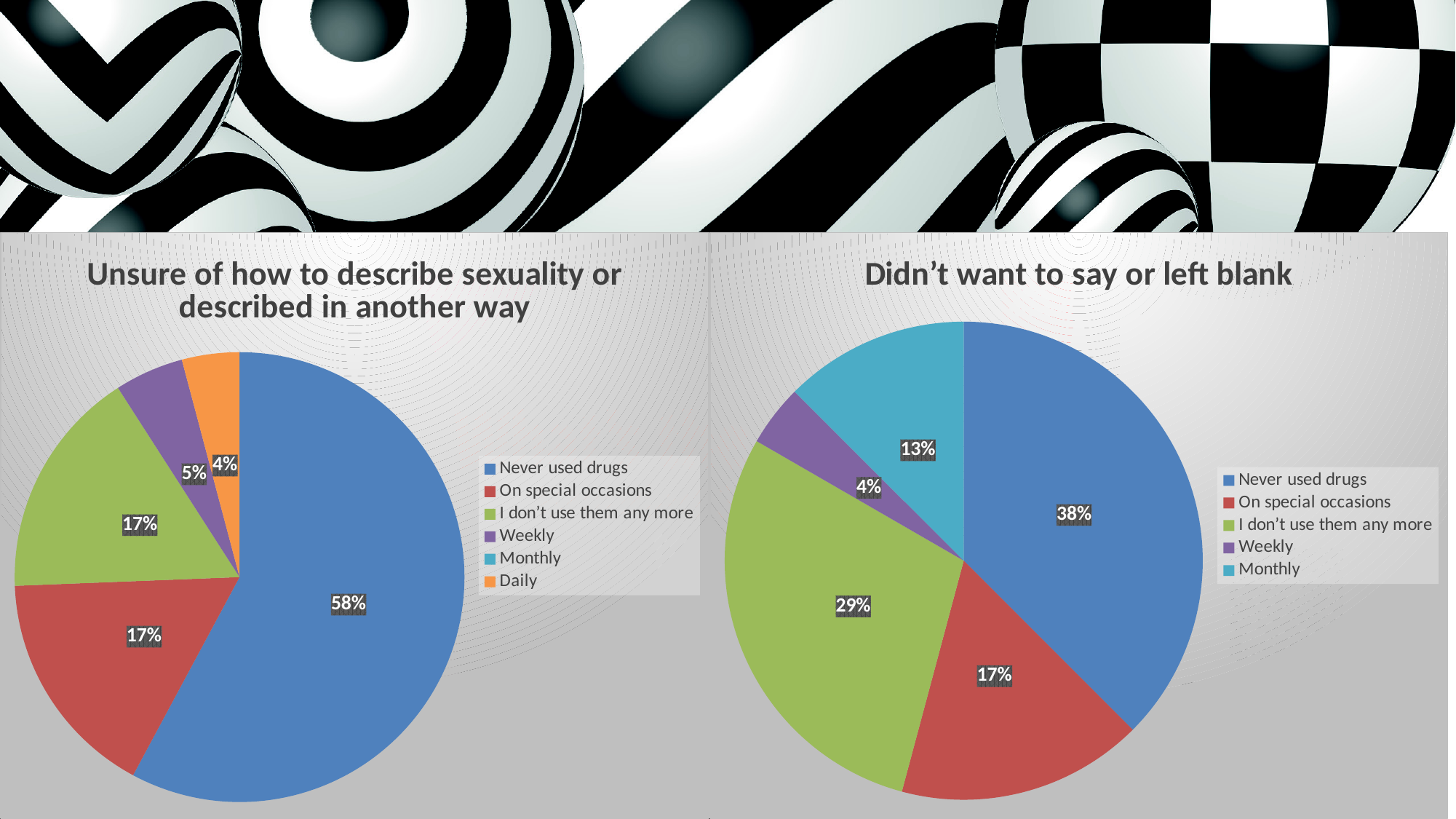
What kind of chart is the 'Unsure of how to describe sexuality or described in another way' chart? Pie chart In the 'Didn't want to say or left blank' chart, what is the difference between 'Never used drugs' and 'I don't use them any more'? 9% In the 'Unsure of how to describe sexuality or described in another way' chart, what share is 'Daily'? 4% In the 'Didn't want to say or left blank' chart, which category has the smallest share? Weekly How many entries does the legend of the 'Unsure of how to describe sexuality or described in another way' chart list? 6 In the 'Unsure of how to describe sexuality or described in another way' chart, what share is 'Weekly'? 5% In the 'Didn't want to say or left blank' chart, which category has the largest share? Never used drugs In the 'Didn't want to say or left blank' chart, what share is 'I don't use them any more'? 29% How many entries does the legend of the 'Didn't want to say or left blank' chart list? 5 In the 'Didn't want to say or left blank' chart, what share is 'Monthly'? 13% In the 'Unsure of how to describe sexuality or described in another way' chart, which is larger: 'Weekly' or 'Daily'? Weekly In the 'Unsure of how to describe sexuality or described in another way' chart, what share is 'Never used drugs'? 58%